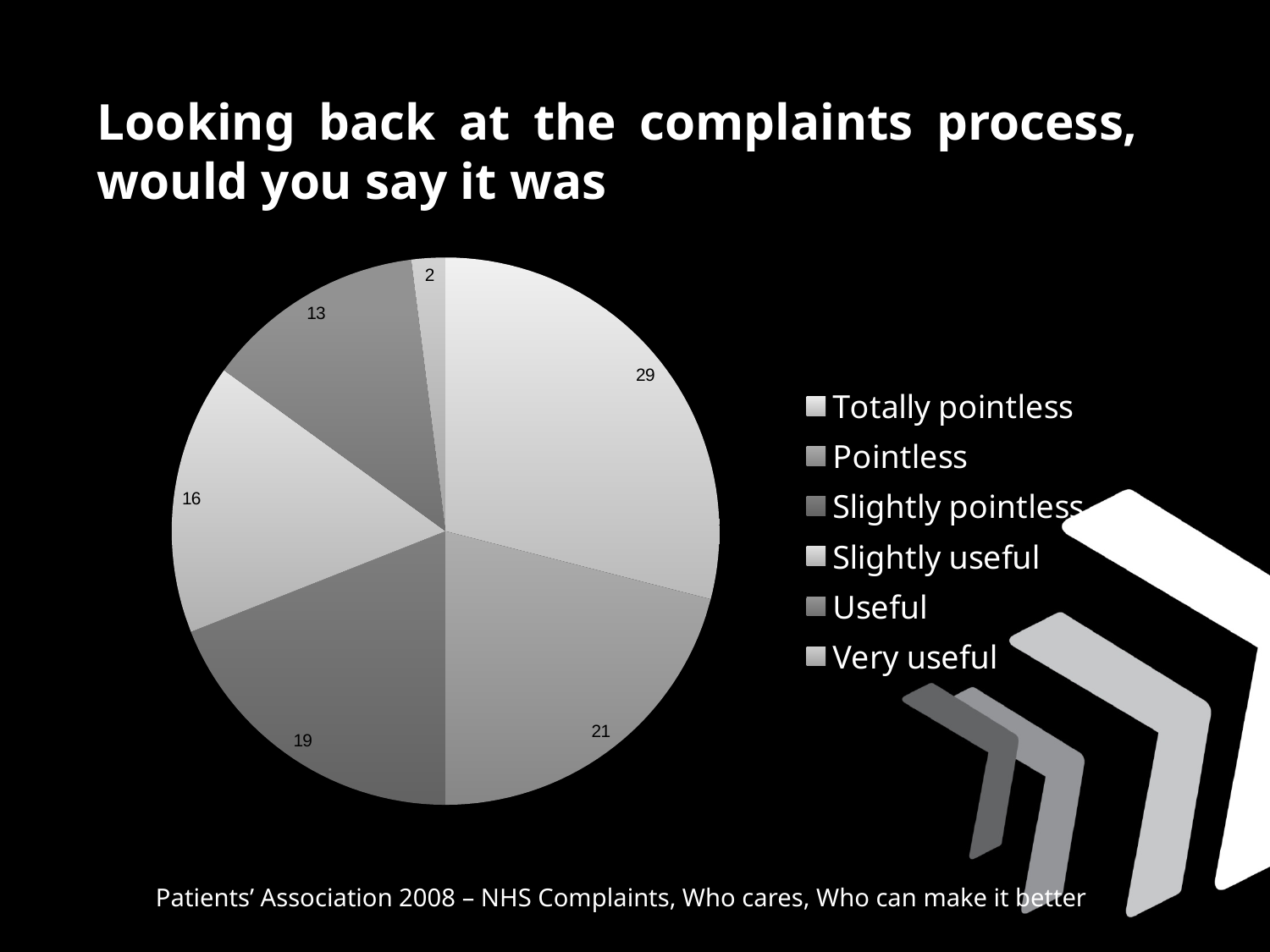
What is the value for Totally pointless? 29 What is the difference between the values for Totally pointless and Pointless? 8 Which category has the smallest slice of the pie? Very useful How many slices does the pie chart have? 6 What is the source cited at the bottom of the slide? Patients' Association 2008 – NHS Complaints, Who cares, Who can make it better Which is larger, the value for Slightly pointless or the value for Useful? Slightly pointless What is the value for Slightly useful? 16 How many entries does the legend list? 6 What is the value for Very useful? 2 Which category has the largest slice of the pie? Totally pointless What kind of chart is shown on the slide? pie chart What is the total of all the slice values in the pie chart? 100